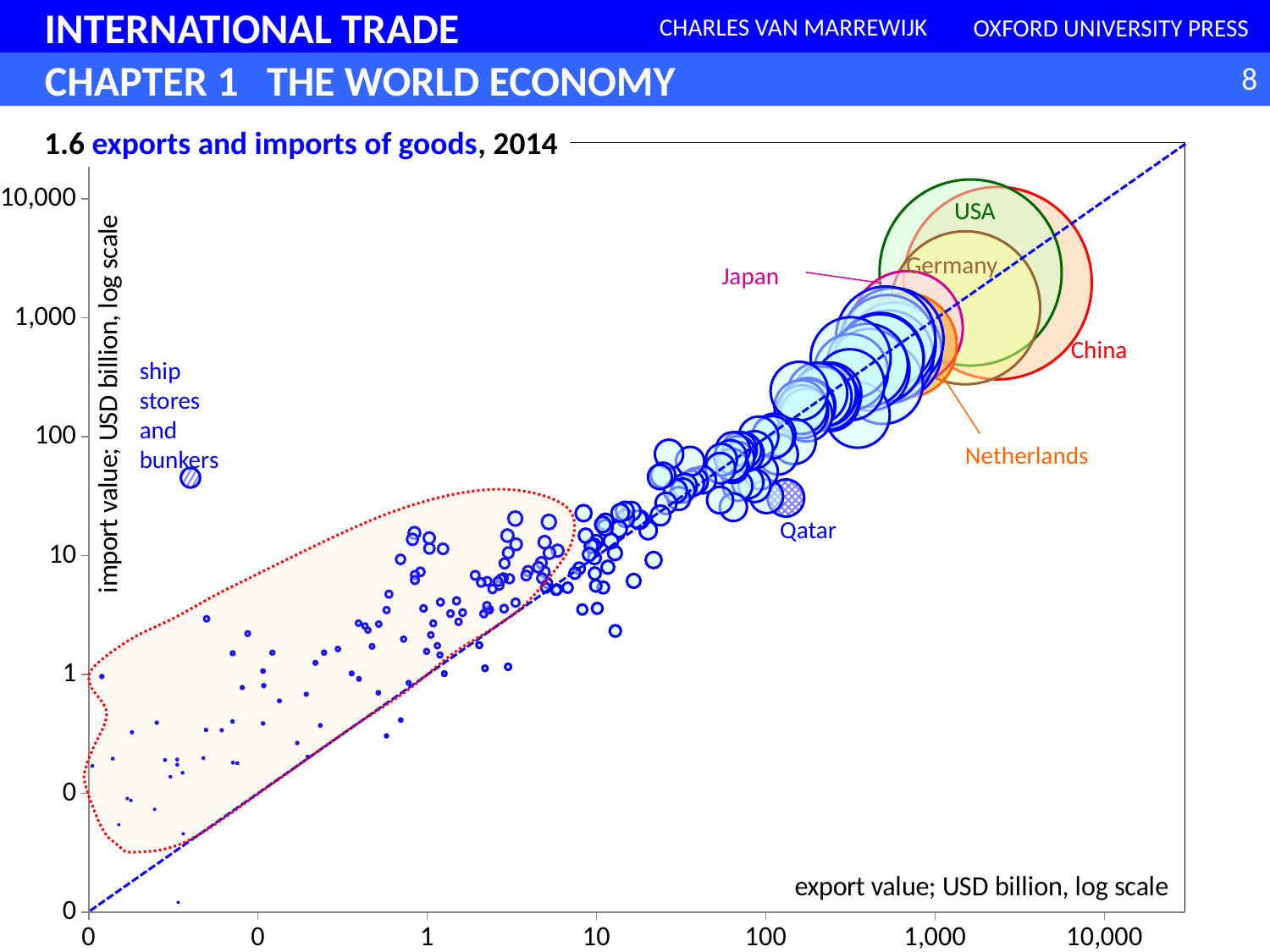
What is the label of the vertical axis? import value; USD billion, log scale Which labeled country has the highest export value? China What is the title of the chart? 1.6 exports and imports of goods, 2014 Which has the larger import value, Germany or Netherlands? Germany Is the import value for ship stores and bunkers greater or less than 100? less Is the import value for Qatar greater or less than 100? less Is the import value for USA greater or less than 1,000? greater Which has the larger export value, China or USA? China How many countries are labeled by name on the chart? 6 What kind of chart is shown on the slide? bubble chart